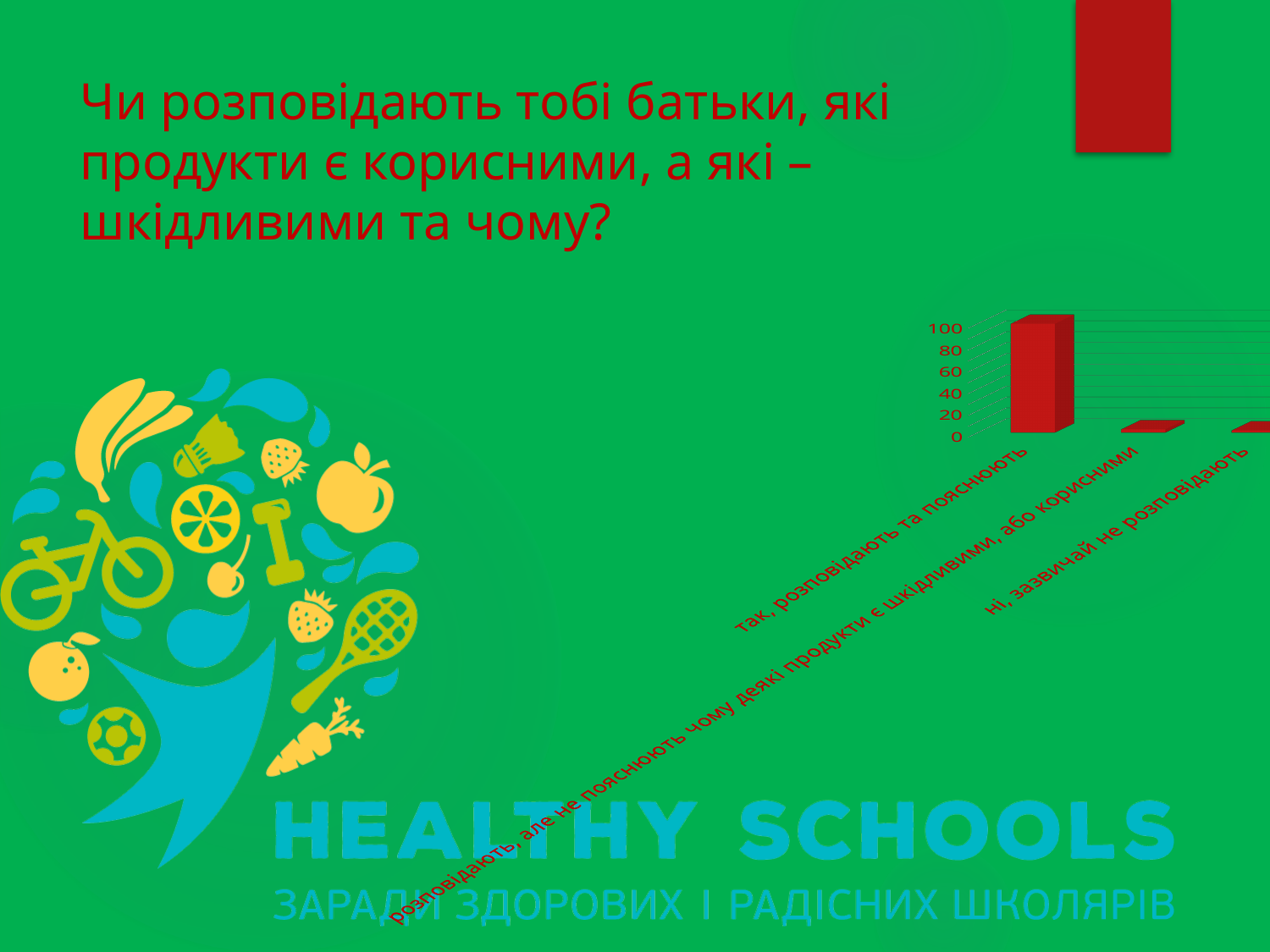
What kind of chart is shown on the slide? bar chart What colour are the bars in the chart? red Is the value for "розповідають, але не пояснюють чому деякі продукти є шкідливими, або корисними" greater or less than 20? less Which category has the highest bar in the chart? так, розповідають та пояснюють How many categories are shown on the x axis of the chart? 3 What is the highest tick value shown on the vertical axis of the chart? 100 Is the value for "так, розповідають та пояснюють" greater or less than 80? greater Which is larger: the value for "так, розповідають та пояснюють" or the value for "ні, зазвичай не розповідають"? так, розповідають та пояснюють Is the value for "ні, зазвичай не розповідають" greater or less than 20? less